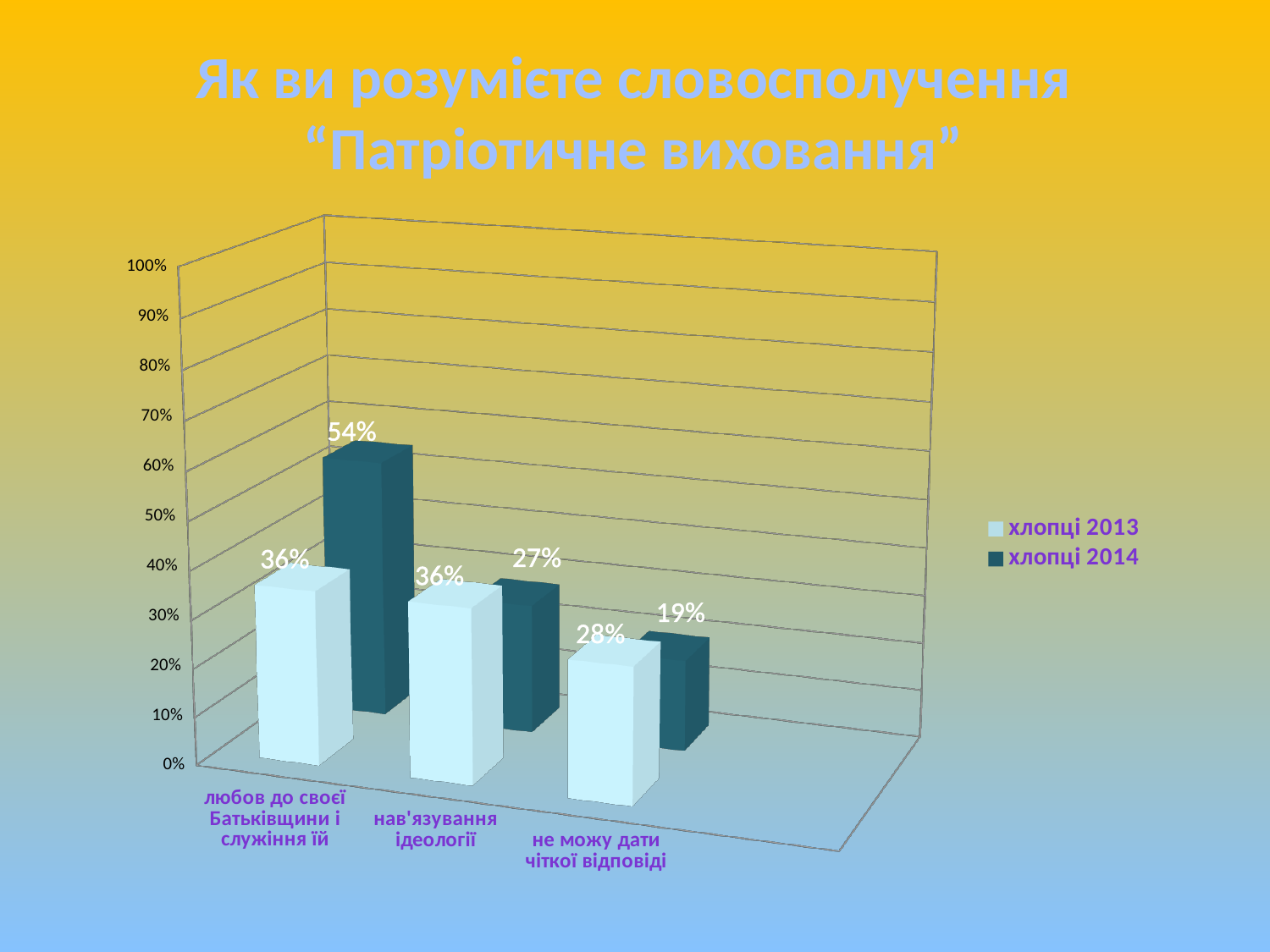
Do the values for "хлопці 2014" rise or fall from left to right along the x axis? fall What is the value for "хлопці 2014" in the category "нав'язування ідеології"? 27% What is the value for "хлопці 2014" in the category "любов до своєї Батьківщини і служіння їй"? 54% How many categories are shown on the x axis? 3 In the category "нав'язування ідеології", which series has the larger value, "хлопці 2013" or "хлопці 2014"? хлопці 2013 What kind of chart is shown on the slide? bar chart What is the difference between the "хлопці 2014" and "хлопці 2013" values in the category "любов до своєї Батьківщини і служіння їй"? 18% What is the title of the chart on the slide? Як ви розумієте словосполучення “Патріотичне виховання” How many series does the legend list? 2 Which category has the highest value for "хлопці 2014"? любов до своєї Батьківщини і служіння їй Which category has the lowest value for "хлопці 2013"? не можу дати чіткої відповіді What is the value for "хлопці 2013" in the category "не можу дати чіткої відповіді"? 28%